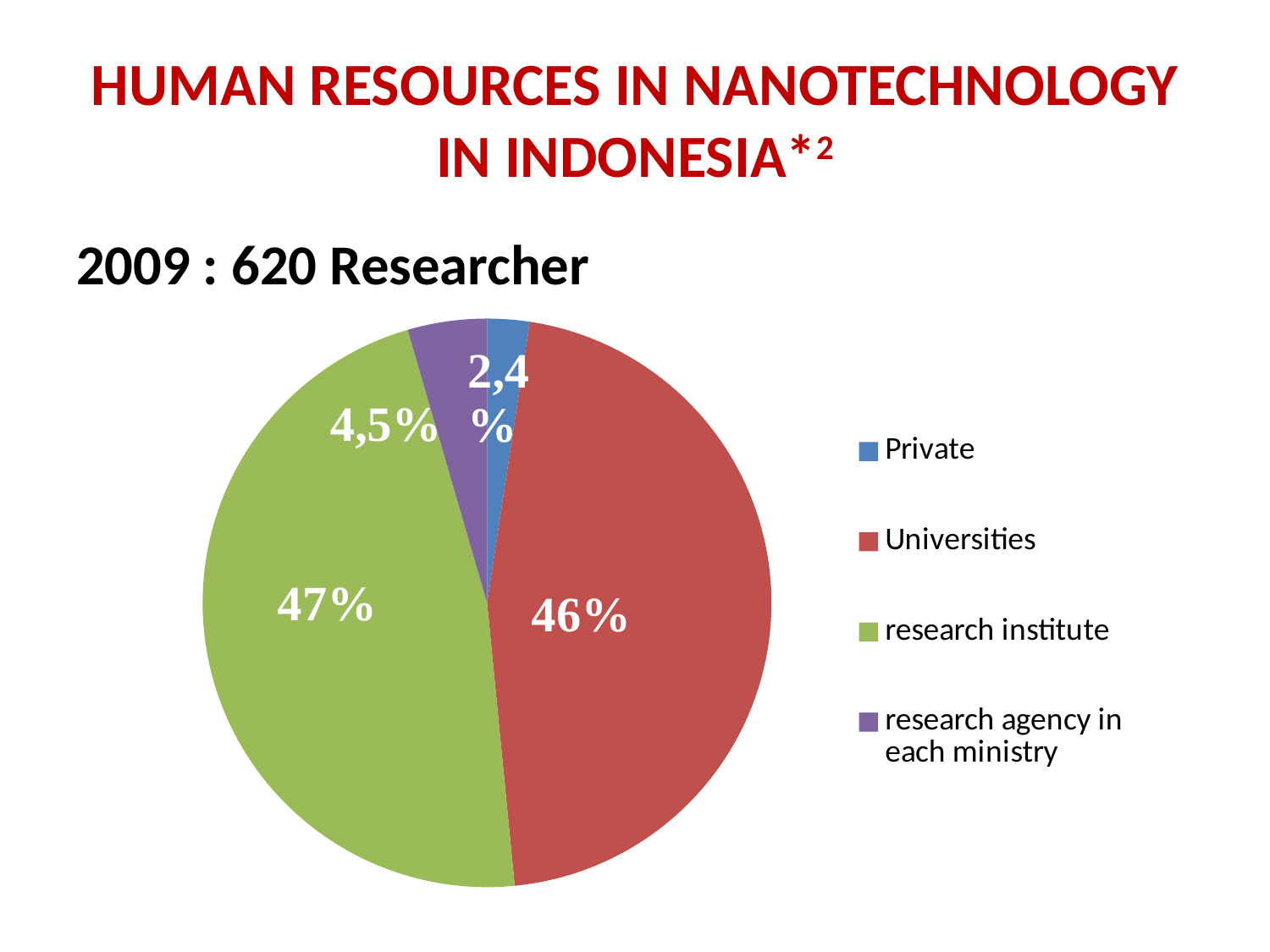
Which is larger, the slice for Private or the slice for research agency in each ministry? research agency in each ministry What share of the pie does Universities hold? 46% What is the difference in percentage points between the research institute slice and the Universities slice? 1 What share of the pie does research institute hold? 47% What kind of chart is shown on the slide? pie chart What share of the pie does research agency in each ministry hold? 4,5% What share of the pie does Private hold? 2,4% Which category has the smallest slice of the pie? Private What colour is the Universities slice? red What is the difference in percentage points between the research agency in each ministry slice and the Private slice? 2,1 How many categories does the legend list? 4 How many researchers does the slide state for 2009? 620